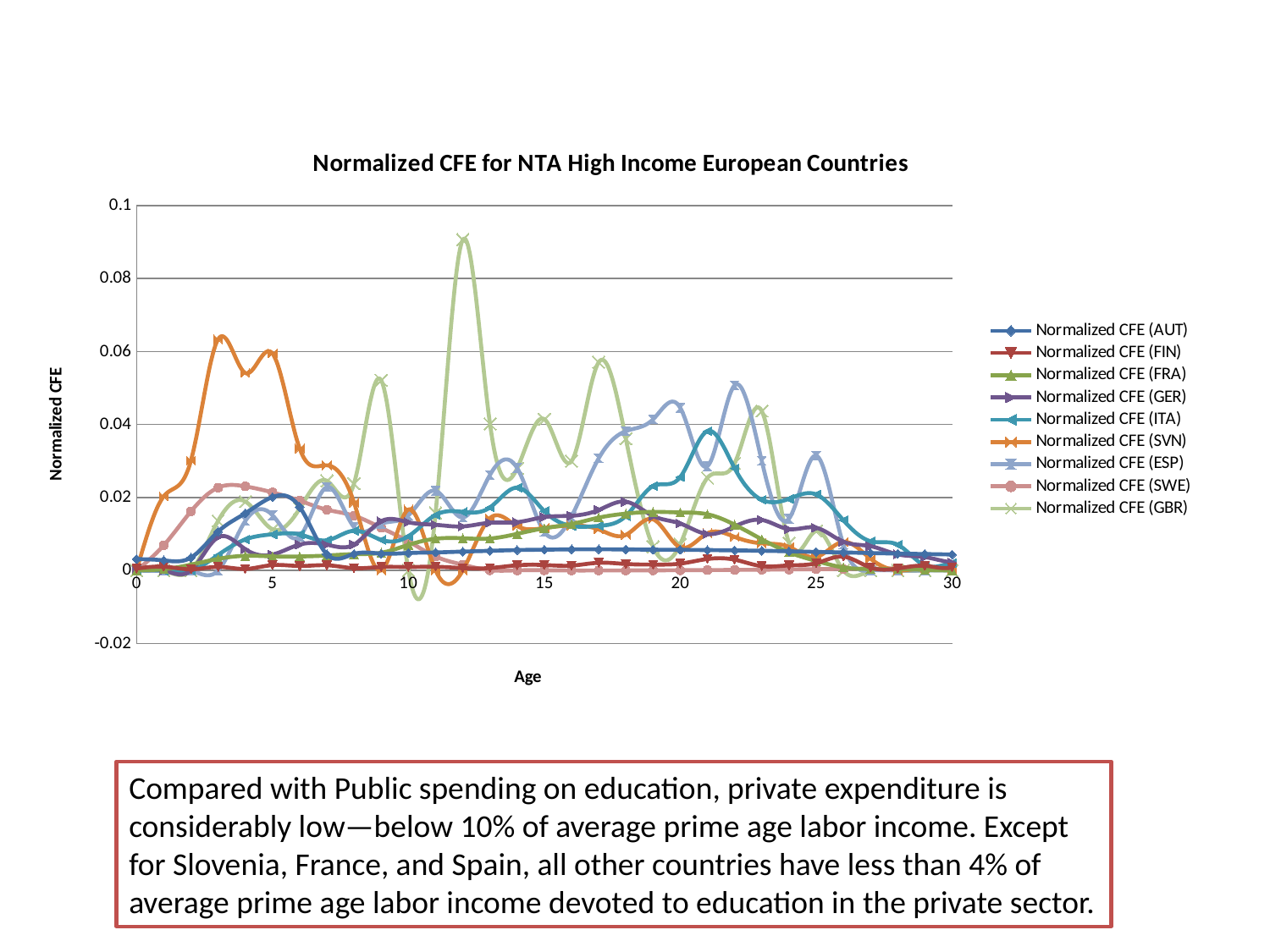
Which series reaches the highest value anywhere on the chart? Normalized CFE (GBR) How many series does the legend list? 9 Is the value for Normalized CFE (FIN) at age 20 greater or less than 0.02? less Is the value for Normalized CFE (SVN) at age 3 greater or less than 0.04? greater At age 12, which is larger: Normalized CFE (GBR) or Normalized CFE (ESP)? Normalized CFE (GBR) Is the value for Normalized CFE (ESP) at age 22 greater or less than 0.04? greater At age 3, which is larger: Normalized CFE (SVN) or Normalized CFE (SWE)? Normalized CFE (SVN) What is the label of the x axis? Age What is the title of the chart? Normalized CFE for NTA High Income European Countries What kind of chart is shown on the slide? Line chart